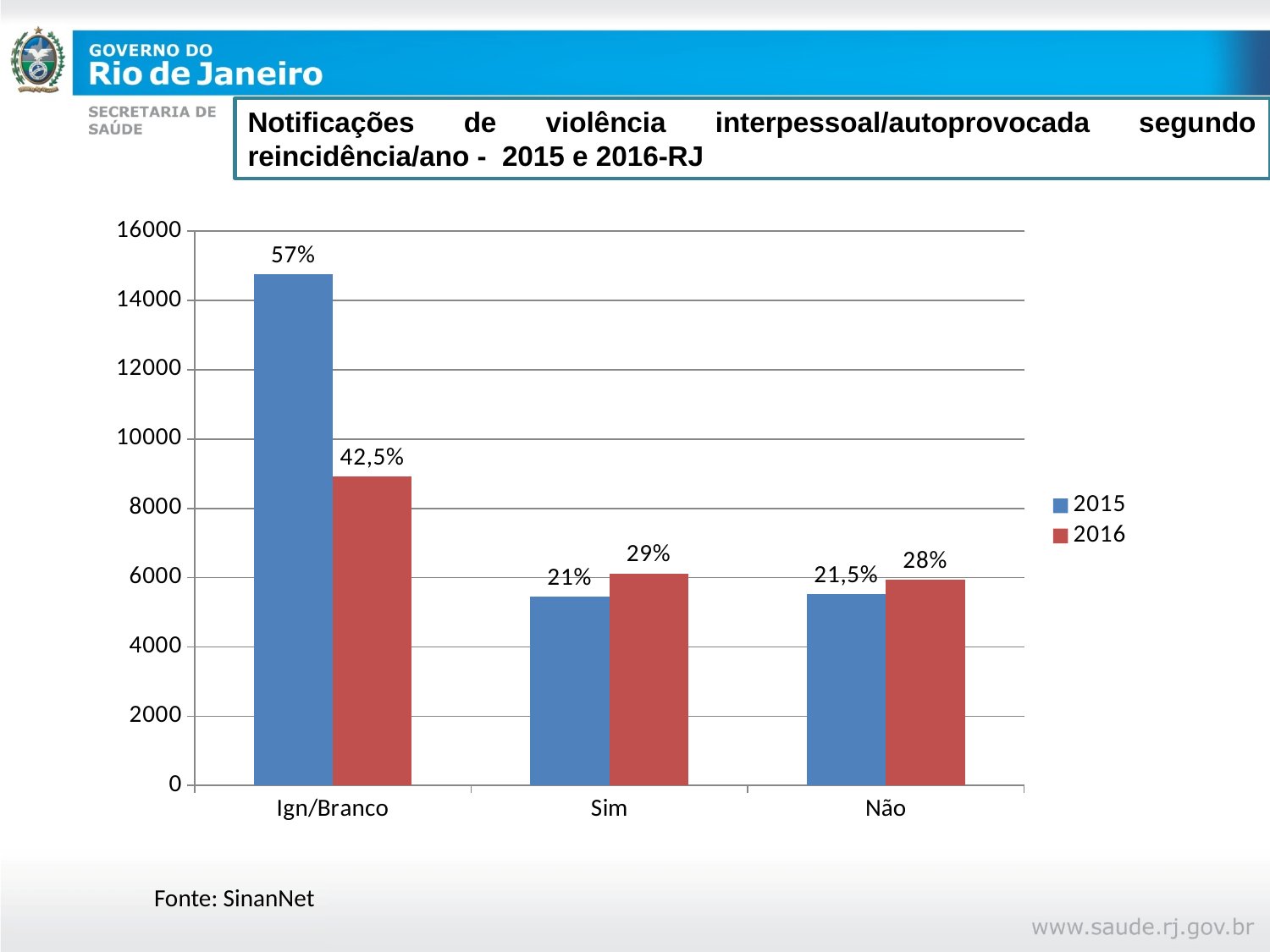
Is the 2015 value for Ign/Branco greater or less than 14000? greater What percentage label is shown on the 2015 bar for Não? 21,5% Which category has the tallest bar for 2015? Ign/Branco Is the 2016 value for Ign/Branco greater or less than 10000? less What percentage label is shown on the 2016 bar for Sim? 29% What kind of chart is shown on the slide? Bar chart What percentage label is shown on the 2015 bar for Ign/Branco? 57% For Sim, which year has the taller bar, 2015 or 2016? 2016 Which category has the shortest bar for 2016? Não What percentage label is shown on the 2016 bar for Ign/Branco? 42,5% How many series does the legend list? 2 How many categories are shown on the x axis? 3